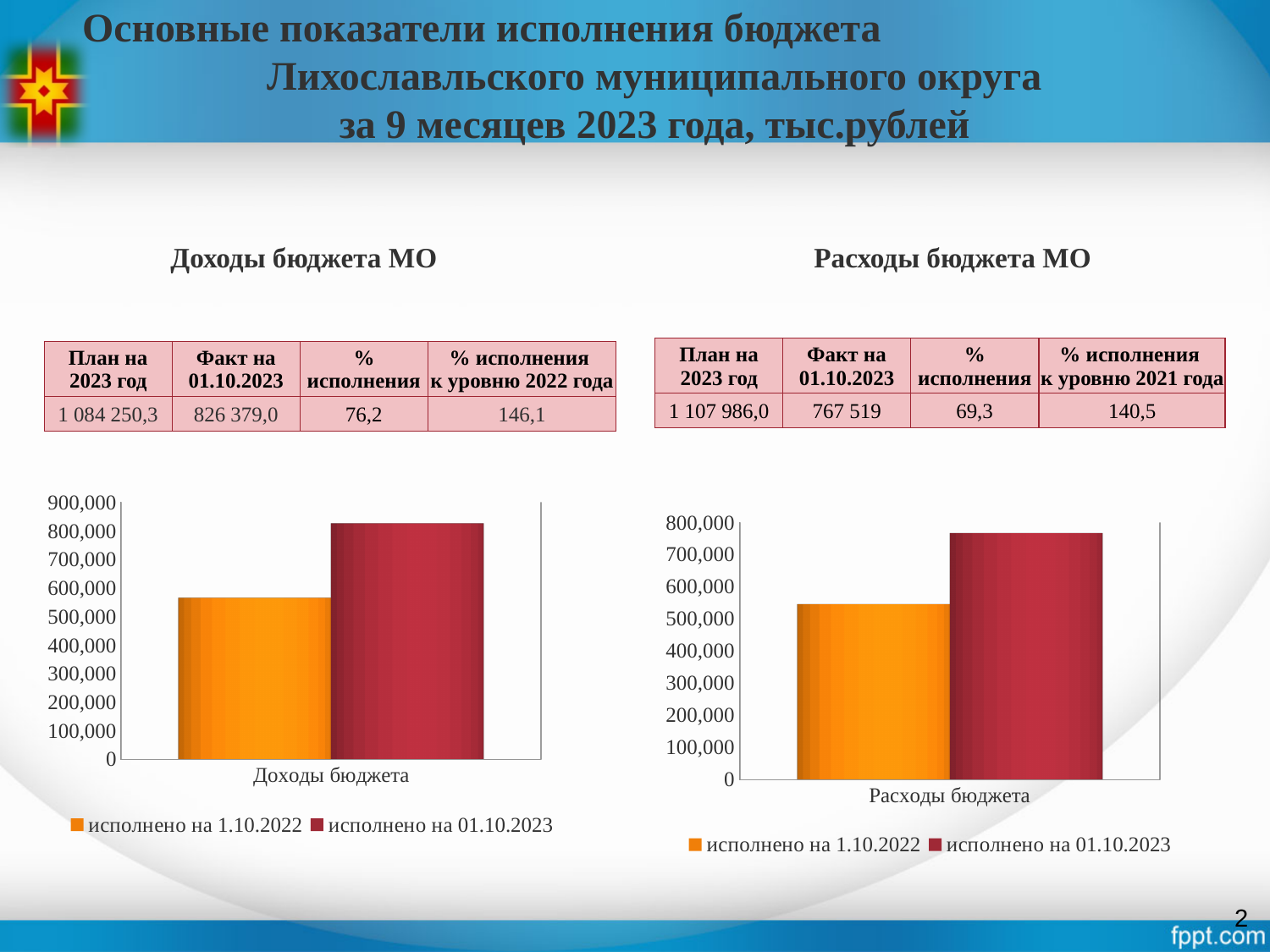
In the right chart (Расходы бюджета), is the value for исполнено на 01.10.2023 greater or less than 700,000? greater In the left chart (Доходы бюджета), how many series does the legend list? 2 What kind of chart is the left chart (Доходы бюджета)? bar chart In the right chart (Расходы бюджета), which series has the taller bar: исполнено на 1.10.2022 or исполнено на 01.10.2023? исполнено на 01.10.2023 In the left chart (Доходы бюджета), is the value for исполнено на 01.10.2023 greater or less than 800,000? greater In the right chart (Расходы бюджета), is the value for исполнено на 1.10.2022 greater or less than 500,000? greater In the left chart (Доходы бюджета), which series has the taller bar: исполнено на 1.10.2022 or исполнено на 01.10.2023? исполнено на 01.10.2023 In the right chart (Расходы бюджета), how many series does the legend list? 2 In the left chart (Доходы бюджета), how many categories are shown on the x axis? 1 In the left chart (Доходы бюджета), what is the first legend entry? исполнено на 1.10.2022 In the right chart, what is the category label shown on the x axis? Расходы бюджета